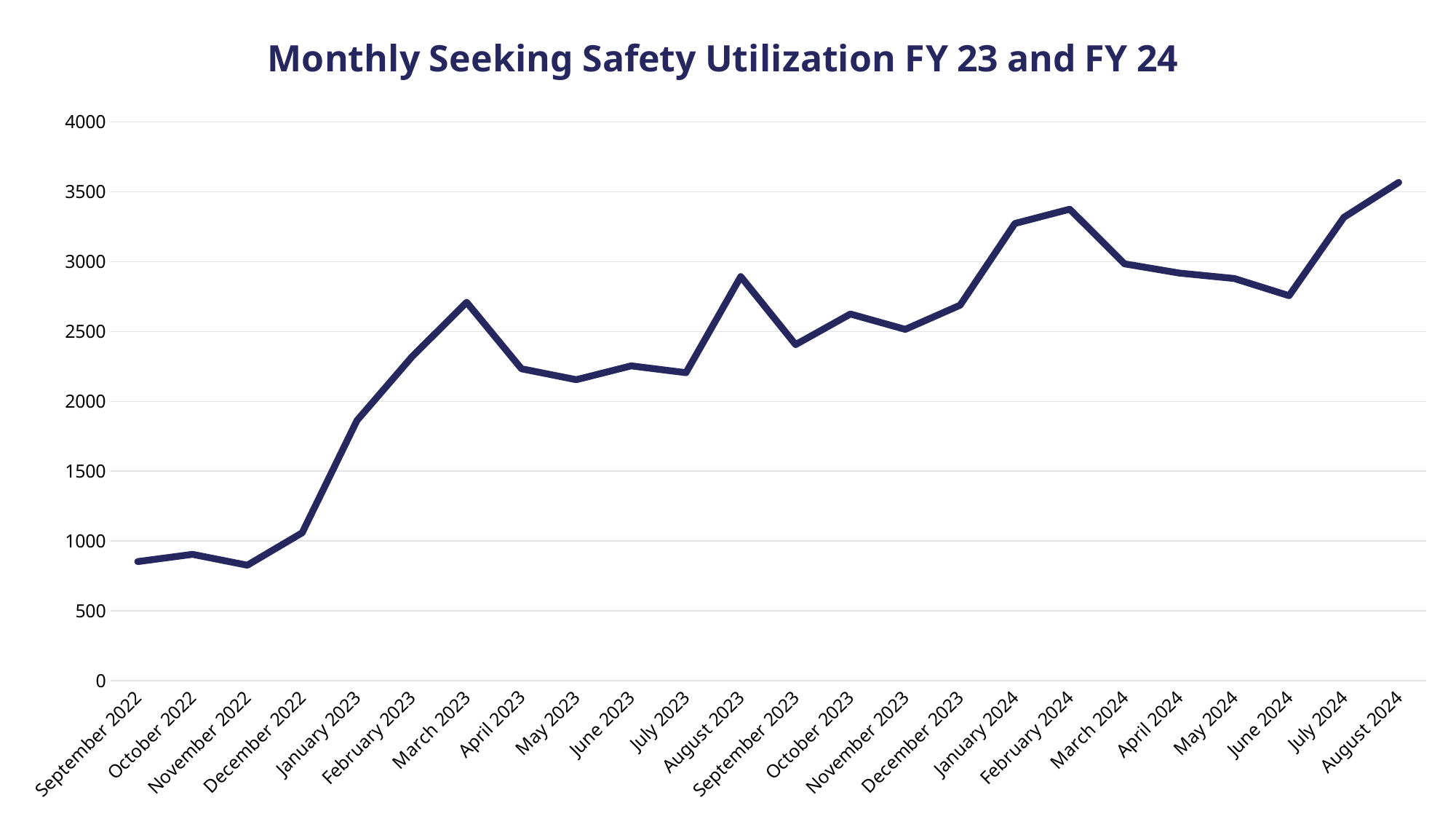
Which is larger, the value for March 2023 or the value for April 2023? March 2023 Overall, do the values rise or fall from September 2022 to August 2024? rise Which is larger, the value for August 2023 or the value for September 2023? August 2023 Which month has the highest value on the chart? August 2024 Is the value for March 2023 greater or less than 2500? greater Is the value for January 2023 greater or less than 2000? less How many months are plotted along the x axis? 24 What is the title of the chart? Monthly Seeking Safety Utilization FY 23 and FY 24 What kind of chart is shown on the slide? line chart Is the value for September 2022 greater or less than 1000? less